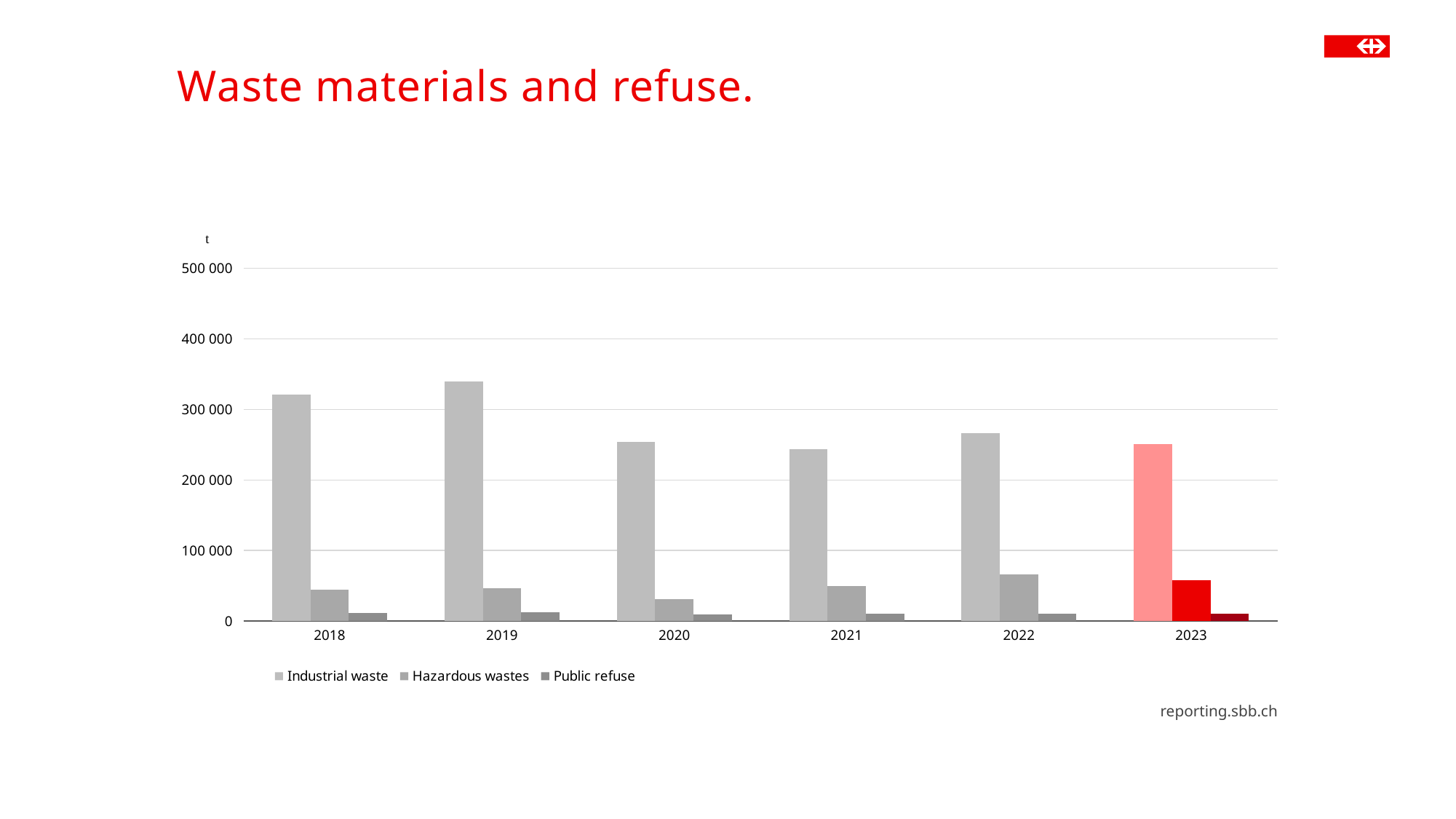
What unit is shown at the top of the y axis? t How many years are shown on the x axis? 6 In which year is Hazardous wastes lowest? 2020 Is the value for Hazardous wastes in 2022 greater or less than 100 000? less Which is larger, Hazardous wastes in 2020 or in 2021? 2021 How many series does the legend list? 3 What kind of chart is shown on the slide? bar chart Is the value for Industrial waste in 2019 greater or less than 300 000? greater Is the value for Industrial waste in 2020 greater or less than 300 000? less Which is larger, Industrial waste in 2018 or in 2019? 2019 In which year is Hazardous wastes highest? 2022 In which year is Industrial waste highest? 2019